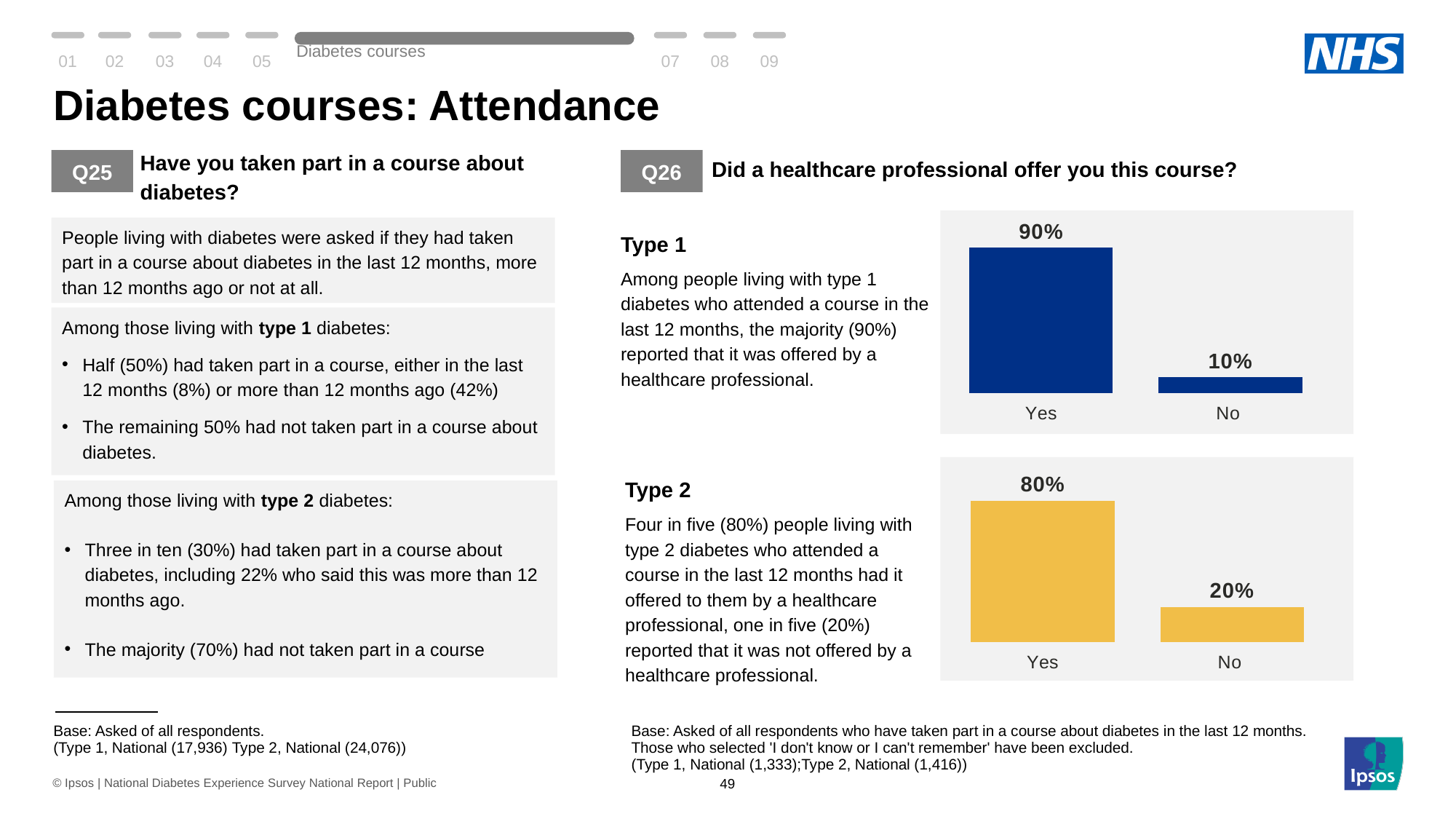
In the Type 2 chart, which category has the lowest value? No In the Type 1 chart, what is the difference between the Yes and No values? 80% In the Type 1 chart, which category has the highest value? Yes How many categories are shown in the Type 2 chart? 2 In the Type 2 chart, what percentage answered Yes? 80% In the Type 1 chart, what percentage answered No? 10% In the Type 2 chart, what percentage answered No? 20% In the Type 1 chart, what percentage answered Yes? 90% Is the Yes value larger in the Type 1 chart or the Type 2 chart? Type 1 What kind of chart is the Type 1 chart? Bar chart In the Type 2 chart, what is the difference between the Yes and No values? 60% What colour are the bars in the Type 2 chart? Yellow